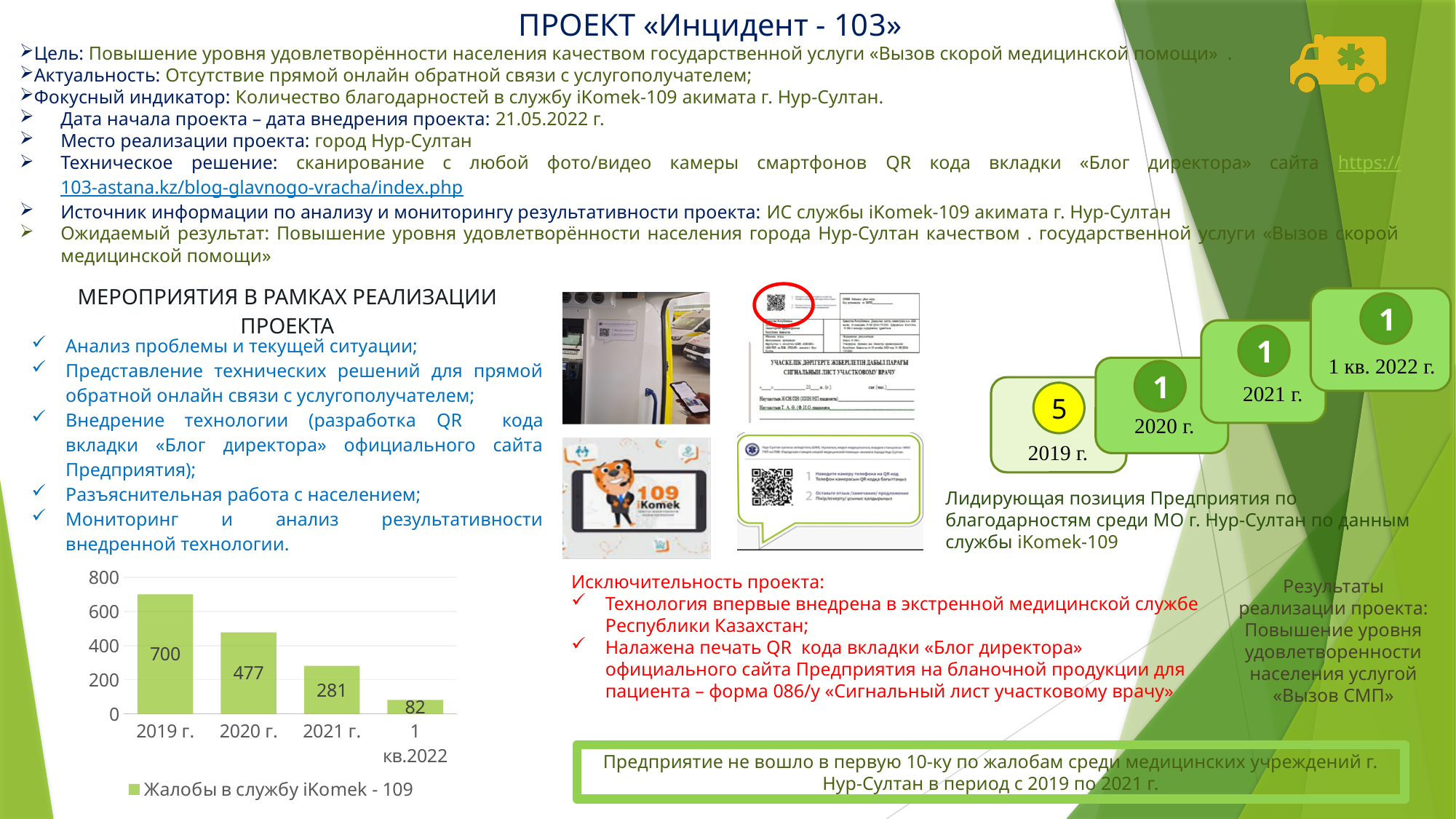
What is the value for 2021 г. in the bar chart? 281 What is the value for 2020 г. in the bar chart? 477 What is the value for 1 кв.2022 in the bar chart? 82 Which is larger in the bar chart, the value for 2020 г. or the value for 2021 г.? 2020 г. How many categories are shown on the x axis of the bar chart? 4 What kind of chart is shown at the bottom left of the slide? bar chart What is the value for 2019 г. in the bar chart? 700 Which category has the lowest value in the bar chart? 1 кв.2022 What is the difference between the values for 2019 г. and 2020 г. in the bar chart? 223 Do the values in the bar chart rise or fall from 2019 г. to 1 кв.2022? fall What is the difference between the values for 2021 г. and 1 кв.2022 in the bar chart? 199 Which category has the highest value in the bar chart? 2019 г.